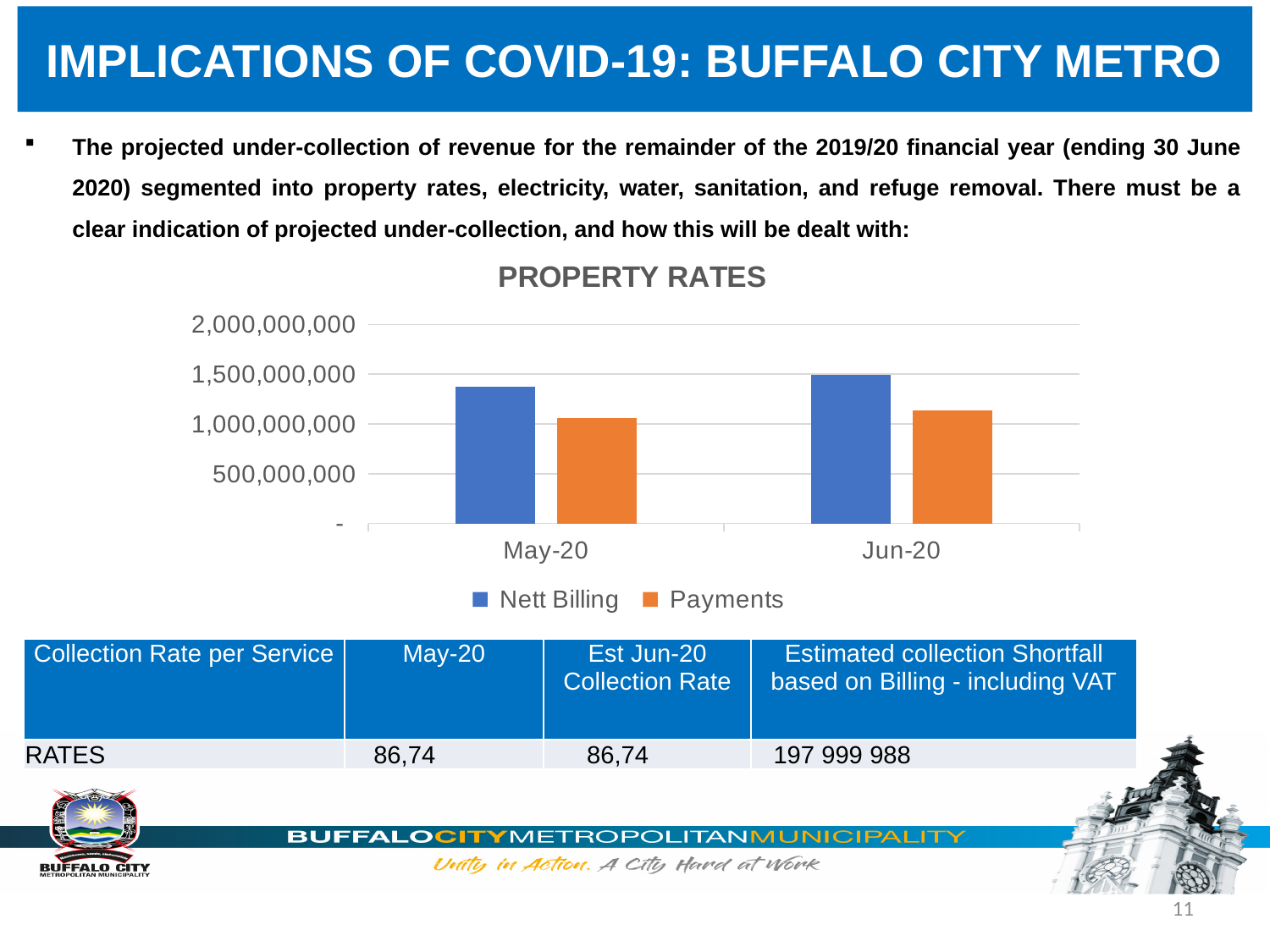
Which bar in the chart is the tallest? Nett Billing for Jun-20 What is the title of the chart? PROPERTY RATES How many series does the chart's legend list? 2 In May-20, which is larger: Nett Billing or Payments? Nett Billing Is the Nett Billing value for May-20 greater or less than 1,000,000,000? greater Does the Payments series rise or fall from May-20 to Jun-20? rise How many categories are shown on the x axis of the chart? 2 Is the Payments value for Jun-20 greater or less than 1,000,000,000? greater Is the Nett Billing value for May-20 greater or less than 1,500,000,000? less Which month has the higher Nett Billing value? Jun-20 What type of chart is shown under the title PROPERTY RATES? bar chart Which series is shown in orange in the chart? Payments